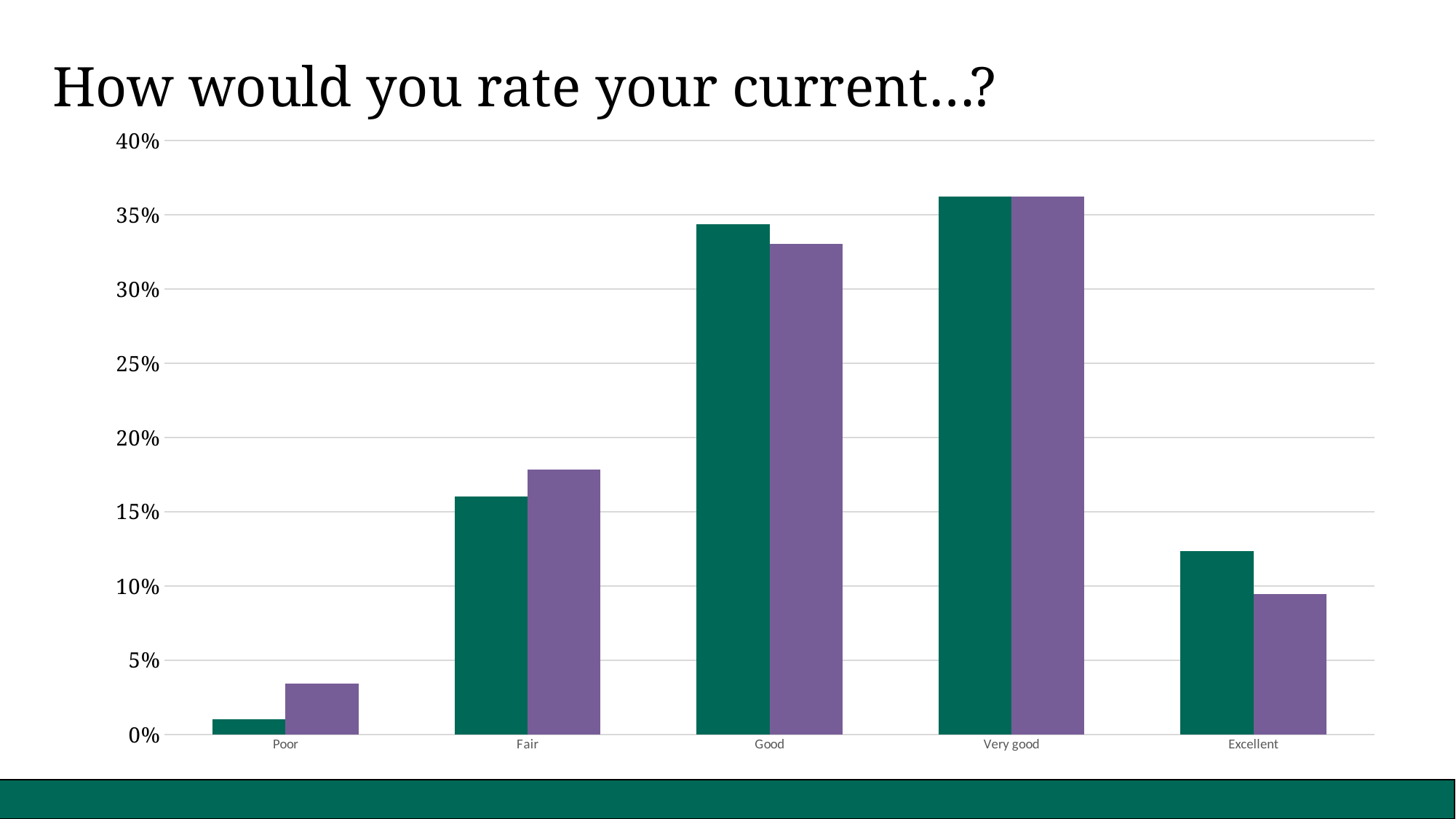
For the Excellent category, which bar is taller, the green one or the purple one? green Which category has the shortest purple bar? Poor How many rating categories are shown on the x axis? 5 What is the title of the slide? How would you rate your current...? Which category has the tallest green bar? Very good What kind of chart is shown on the slide? bar chart Is the green bar for Good greater or less than 30%? greater Is the green bar for Excellent greater or less than 10%? greater Is the purple bar for Poor greater or less than 5%? less Which category has the shortest green bar? Poor For the Poor category, which bar is taller, the green one or the purple one? purple